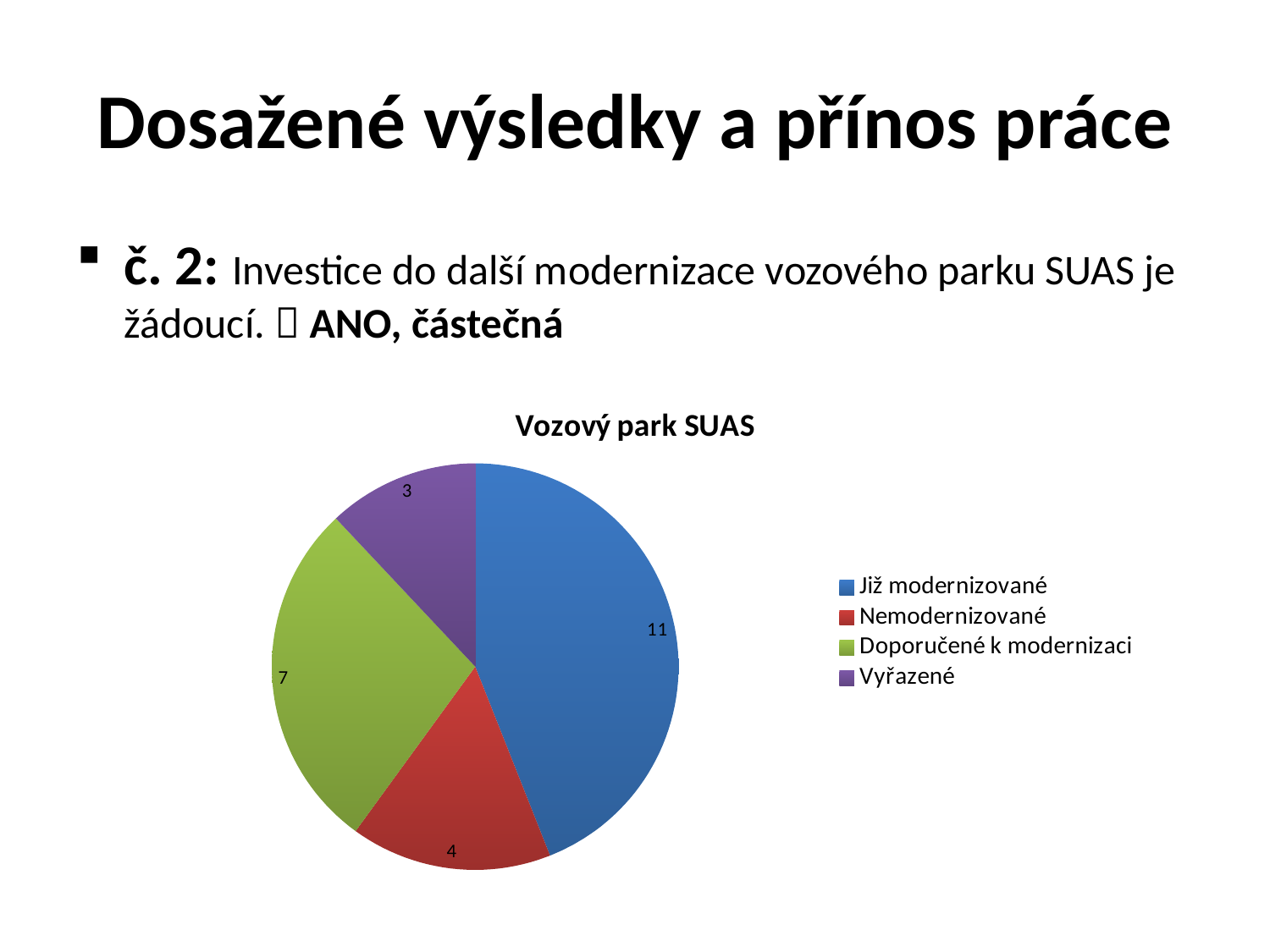
What is the value for Doporučené k modernizaci? 7 What type of chart is shown on the slide? Pie chart What is the value for Nemodernizované? 4 What is the value for Již modernizované? 11 Which category has the largest slice? Již modernizované Which category has the smallest slice? Vyřazené Which is larger, Nemodernizované or Doporučené k modernizaci? Doporučené k modernizaci How many categories does the pie chart have? 4 What is the title of the chart? Vozový park SUAS What is the difference between Již modernizované and Doporučené k modernizaci? 4 What is the value for Vyřazené? 3 What share of the pie does Již modernizované represent? 44%